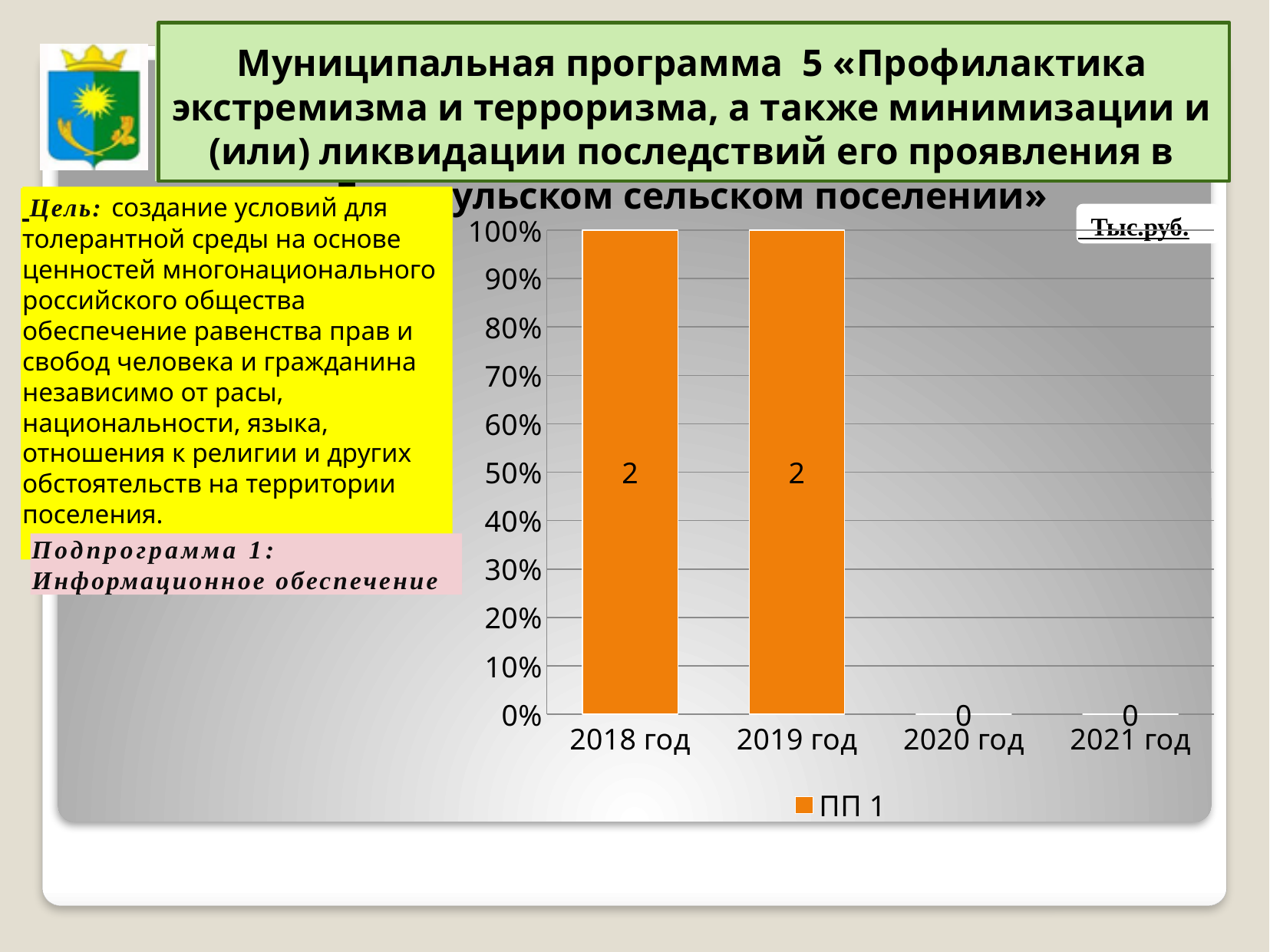
Do the ПП 1 values rise or fall from 2019 год to 2020 год? fall What is the difference between the ПП 1 values for 2018 год and 2020 год? 2 What is the data label for ПП 1 in 2019 год? 2 How many series does the chart legend list? 1 What series name is shown in the chart legend? ПП 1 What kind of chart is shown on the slide? bar chart Which is larger, the ПП 1 value for 2019 год or for 2021 год? 2019 год What unit is indicated in the top right corner of the chart? Тыс.руб. What is the data label for ПП 1 in 2020 год? 0 What is the data label for ПП 1 in 2021 год? 0 What is the data label for ПП 1 in 2018 год? 2 How many categories are shown on the x axis of the chart? 4